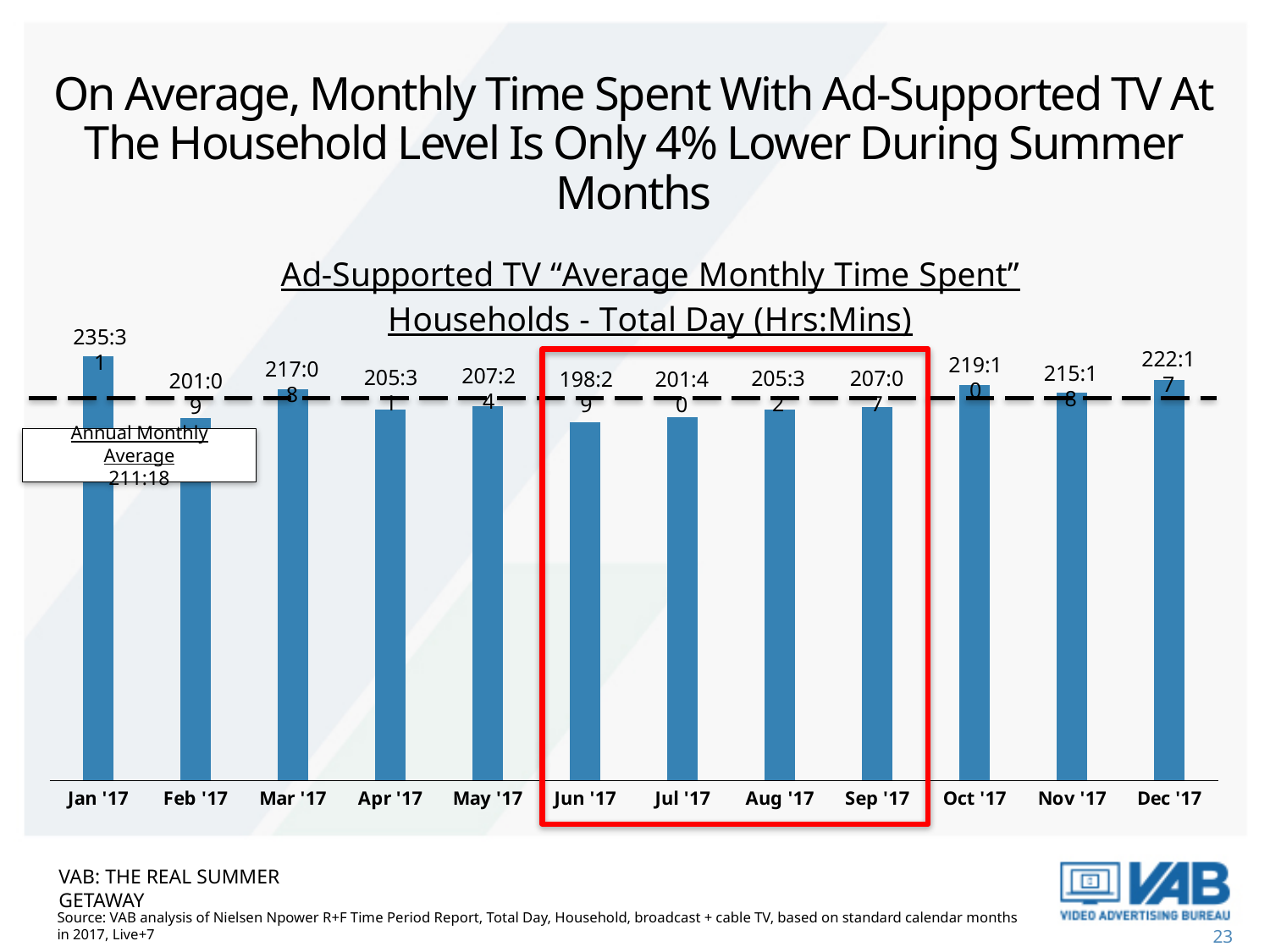
What is the value for Sep '17? 207:07 What kind of chart is shown on the slide? Bar chart What is the value for Jun '17? 198:29 Which month has the highest average monthly time spent? Jan '17 Which is larger, the value for Jun '17 or the value for Dec '17? Dec '17 What is the annual monthly average shown by the dashed line? 211:18 Which is larger, the value for Jan '17 or the value for Feb '17? Jan '17 What is the value for Dec '17? 222:17 What is the difference between the values for Jan '17 and Feb '17? 34:22 Which month has the lowest average monthly time spent? Jun '17 What is the value for Jan '17? 235:31 How many months are shown on the x axis? 12